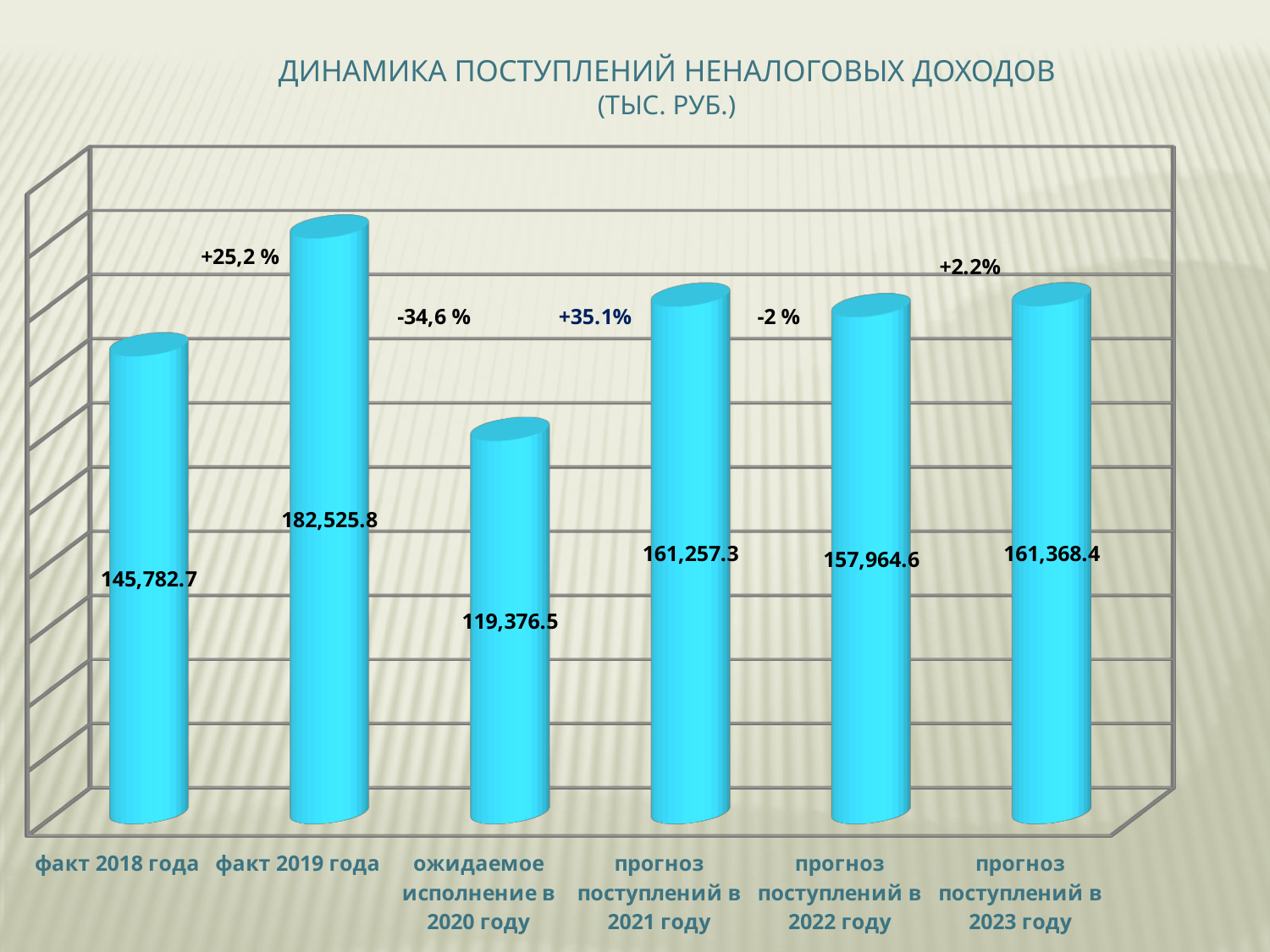
How many categories are plotted in the chart? 6 Which category has the lowest value? ожидаемое исполнение в 2020 году What is the value for "факт 2019 года"? 182,525.8 What is the title of the chart? ДИНАМИКА ПОСТУПЛЕНИЙ НЕНАЛОГОВЫХ ДОХОДОВ (ТЫС. РУБ.) Which category has the highest value? факт 2019 года What is the value for "факт 2018 года"? 145,782.7 Which is larger: the value for "факт 2018 года" or for "прогноз поступлений в 2022 году"? прогноз поступлений в 2022 году What type of chart is shown on the slide? bar chart What is the value for "прогноз поступлений в 2022 году"? 157,964.6 What is the value for "ожидаемое исполнение в 2020 году"? 119,376.5 What percentage change is annotated above the bar for "ожидаемое исполнение в 2020 году"? -34,6 % What is the difference between the values for "факт 2019 года" and "факт 2018 года"? 36,743.1